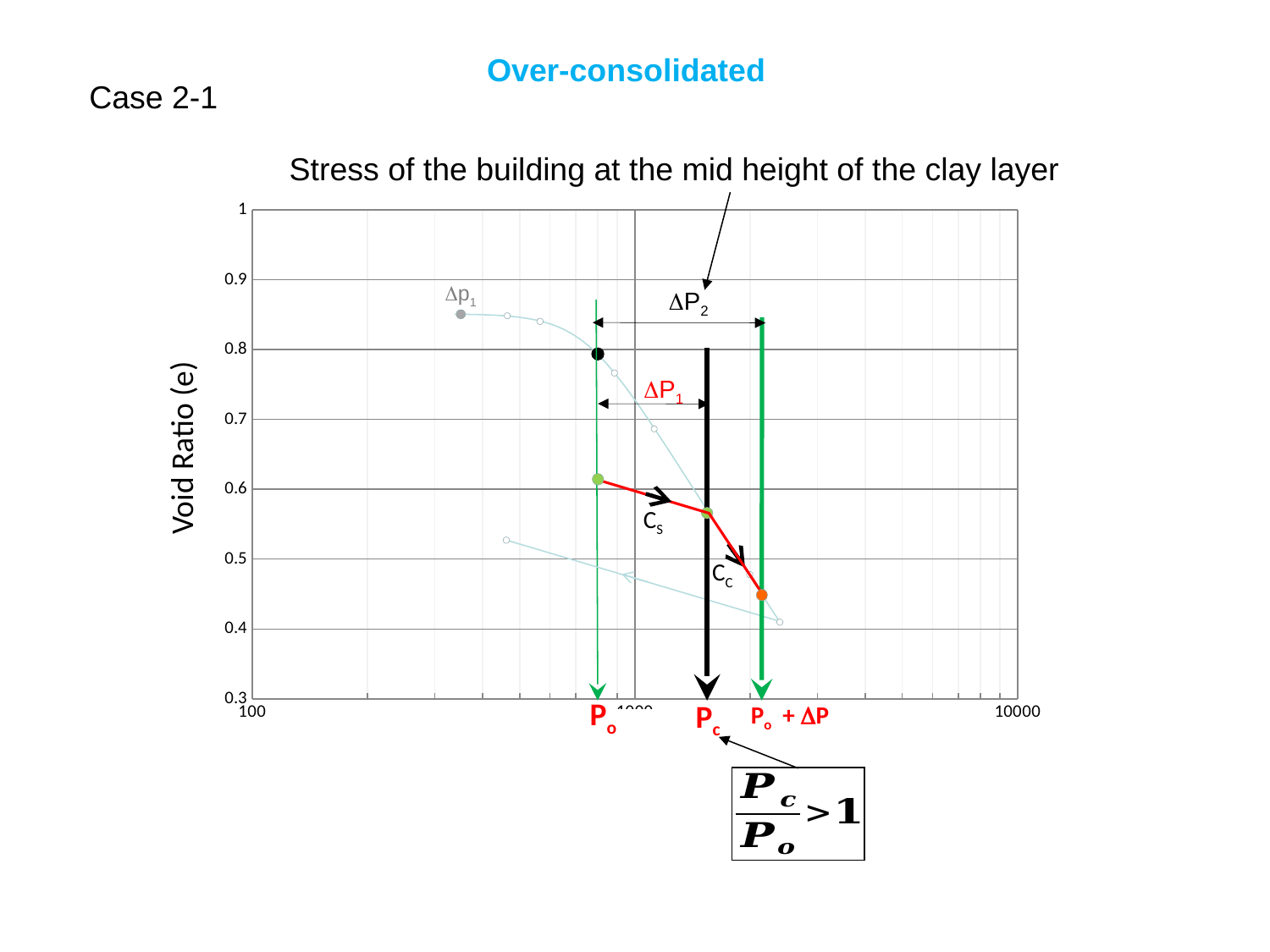
What is the label of the y axis? Void Ratio (e) Is the void ratio at the grey Δp1 point greater or less than 0.8? greater Which has the higher void ratio, the green point at Po or the orange point at Po + ΔP? the green point at Po Which of the three marked stresses, Po, Pc or Po + ΔP, lies furthest to the right on the x axis? Po + ΔP Which stress increment spans a wider range on the x axis, ΔP1 or ΔP2? ΔP2 Does the red line rise or fall as stress increases from Po to Po + ΔP? fall What is the highest value shown on the x axis? 10000 Is the void ratio where the red line crosses the Pc line greater or less than 0.6? less Is the void ratio at the black point on the Po line greater or less than 0.7? greater What kind of chart is shown on the slide? line chart What is the lowest value shown on the y axis? 0.3